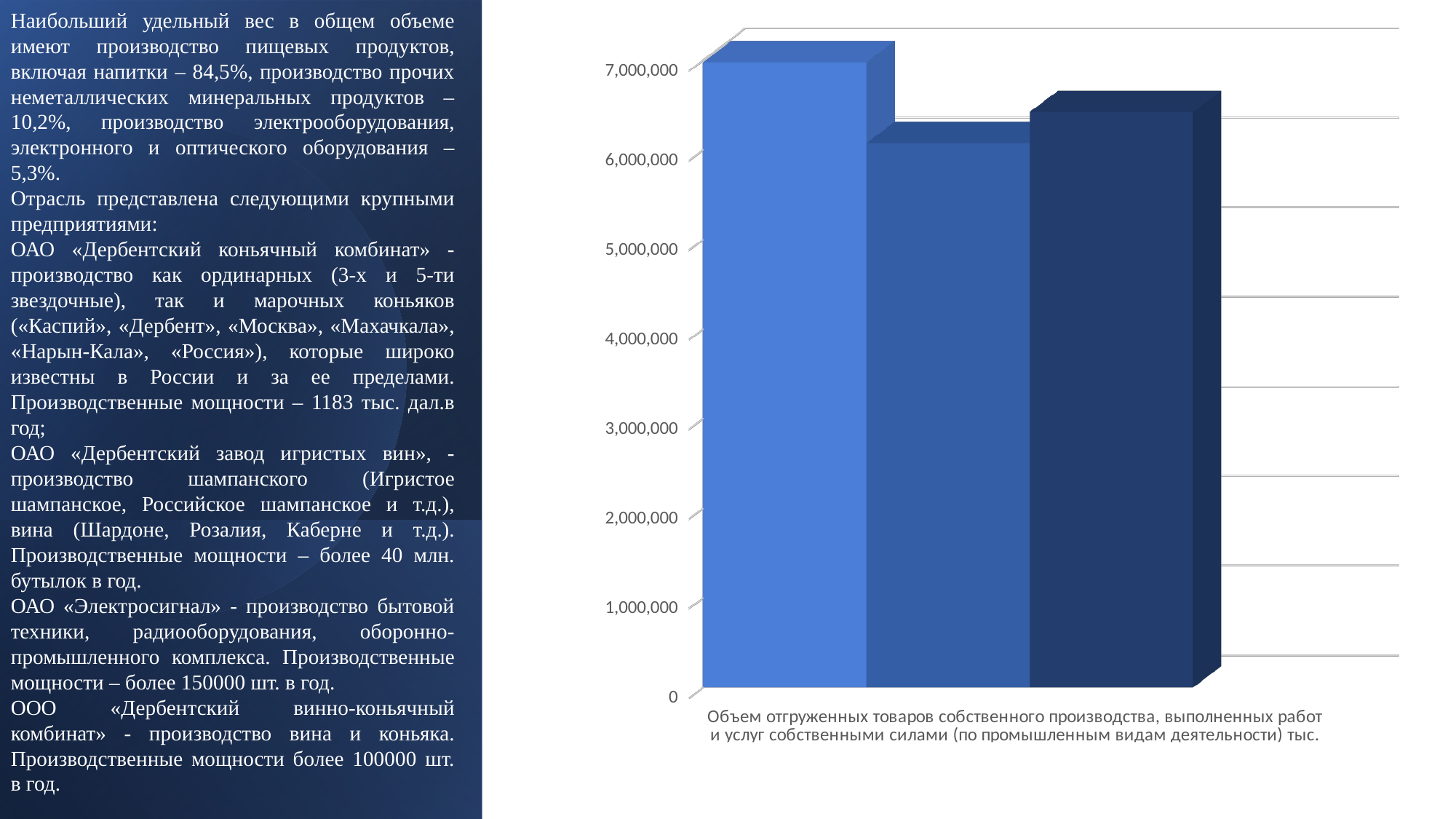
Is the value of the leftmost bar greater or less than 6,000,000? greater Which bar is the shortest in the chart: the leftmost, the middle, or the rightmost? the middle How many bars are plotted in the chart? 3 What unit is given at the end of the category label under the bars? тыс. Is the value of the rightmost bar greater or less than 7,000,000? less Is the value of the rightmost bar greater or less than 6,000,000? greater What is the highest value labelled on the vertical axis of the chart? 7,000,000 Which is larger, the leftmost bar or the rightmost bar? the leftmost bar What kind of chart is shown on the slide? bar chart Which is larger, the middle bar or the rightmost bar? the rightmost bar Which bar is the tallest in the chart: the leftmost, the middle, or the rightmost? the leftmost